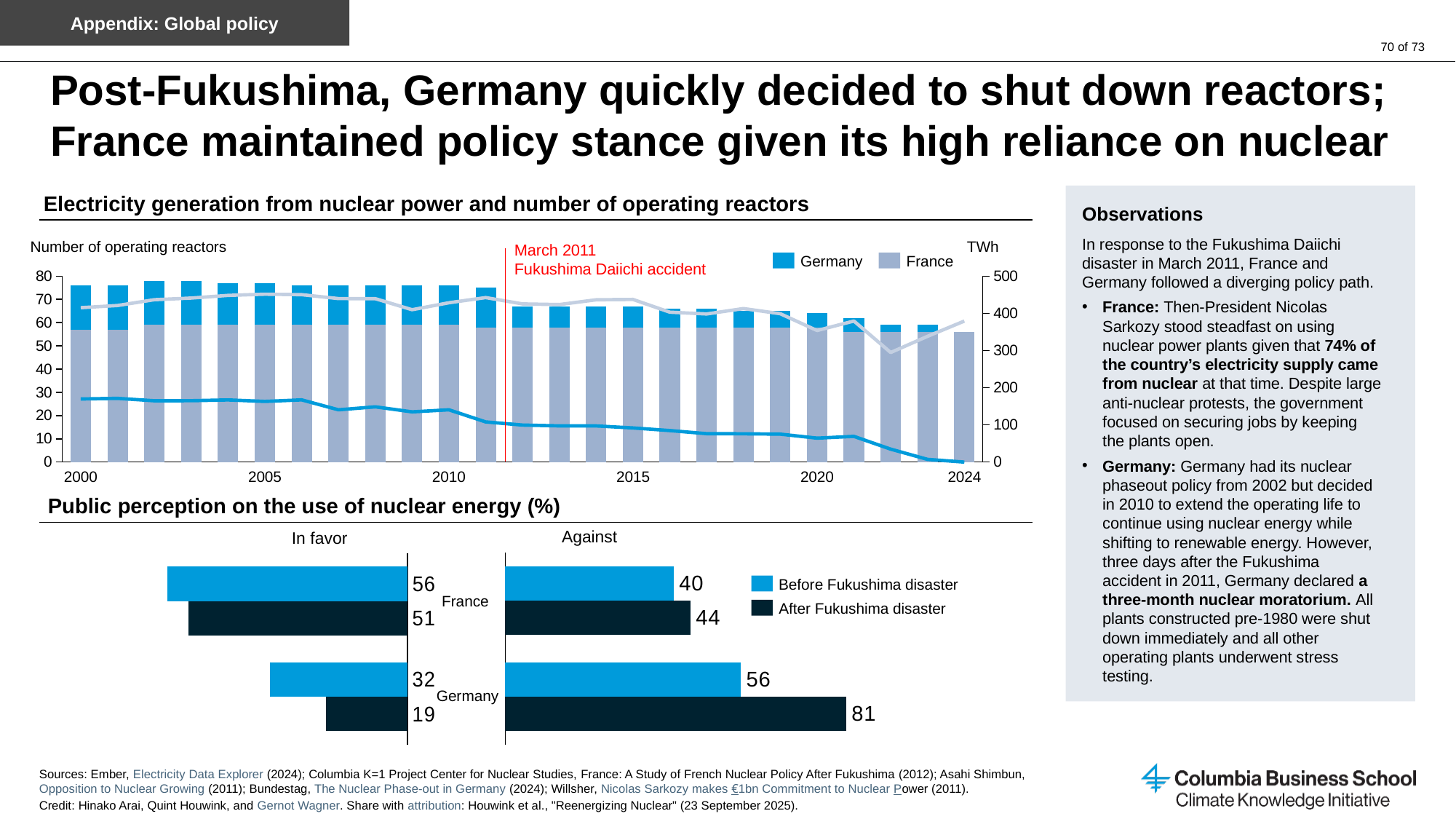
In the 'Public perception on the use of nuclear energy (%)' chart, what percentage of people in Germany were against nuclear energy after the Fukushima disaster? 81 How many series does the legend of the 'Public perception on the use of nuclear energy (%)' chart list? 2 In the 'Public perception on the use of nuclear energy (%)' chart, which bar has the highest value? Germany, Against, After Fukushima disaster (81) In the 'Electricity generation from nuclear power and number of operating reactors' chart, is the total number of operating reactors in 2000 greater or less than 70? greater In the 'Public perception on the use of nuclear energy (%)' chart, what percentage of people in France were in favor of nuclear energy before the Fukushima disaster? 56 In the 'Public perception on the use of nuclear energy (%)' chart, what is the difference between the 'In favor' values for France before and after the Fukushima disaster? 5 In the 'Public perception on the use of nuclear energy (%)' chart, by how many percentage points did the share of Germans against nuclear energy change from before to after the Fukushima disaster? 25 What kind of chart is the 'Public perception on the use of nuclear energy (%)' chart? Bar chart In the 'Public perception on the use of nuclear energy (%)' chart, which is larger: the share of French people against nuclear energy after Fukushima or the share of Germans in favor before Fukushima? French against after Fukushima (44) In the 'Electricity generation from nuclear power and number of operating reactors' chart, which event is marked by the red vertical line? March 2011 Fukushima Daiichi accident In the 'Electricity generation from nuclear power and number of operating reactors' chart, does Germany's electricity generation from nuclear power (TWh) rise or fall from 2000 to 2024? Fall In the 'Public perception on the use of nuclear energy (%)' chart, what percentage of people in Germany were in favor of nuclear energy after the Fukushima disaster? 19